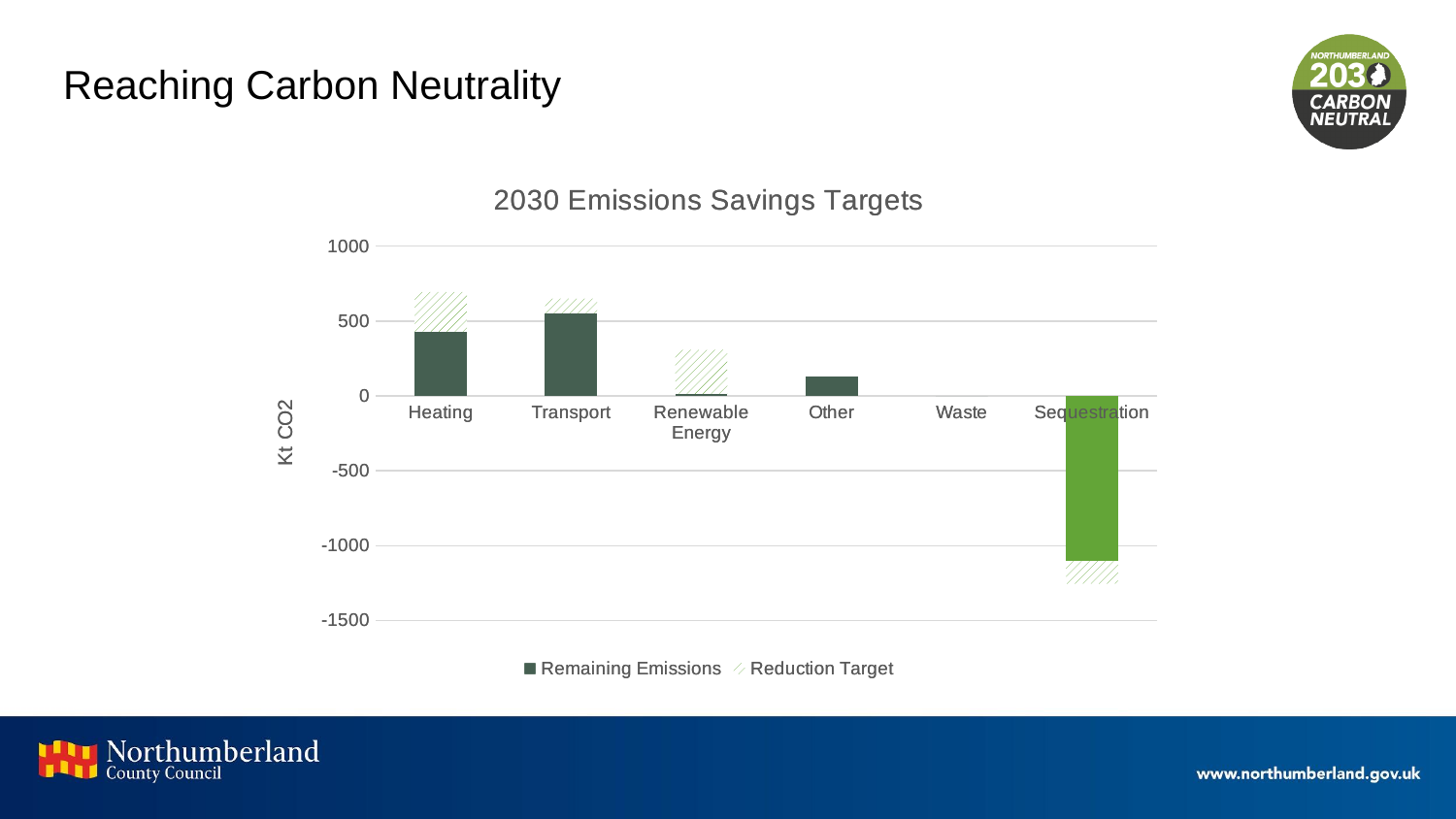
Which has the larger Reduction Target value, Heating or Transport? Heating Is the Reduction Target value for Renewable Energy greater or less than 500? less Which category has a negative value on the chart? Sequestration Is the Remaining Emissions value for Transport greater or less than 500? greater What kind of chart is shown on the slide? Bar chart What is the title of the chart? 2030 Emissions Savings Targets Which category has the highest Remaining Emissions value? Transport Is the Remaining Emissions value for Heating greater or less than 500? less How many series does the legend list? 2 How many categories are shown on the x axis? 6 Which has the larger Remaining Emissions value, Heating or Other? Heating